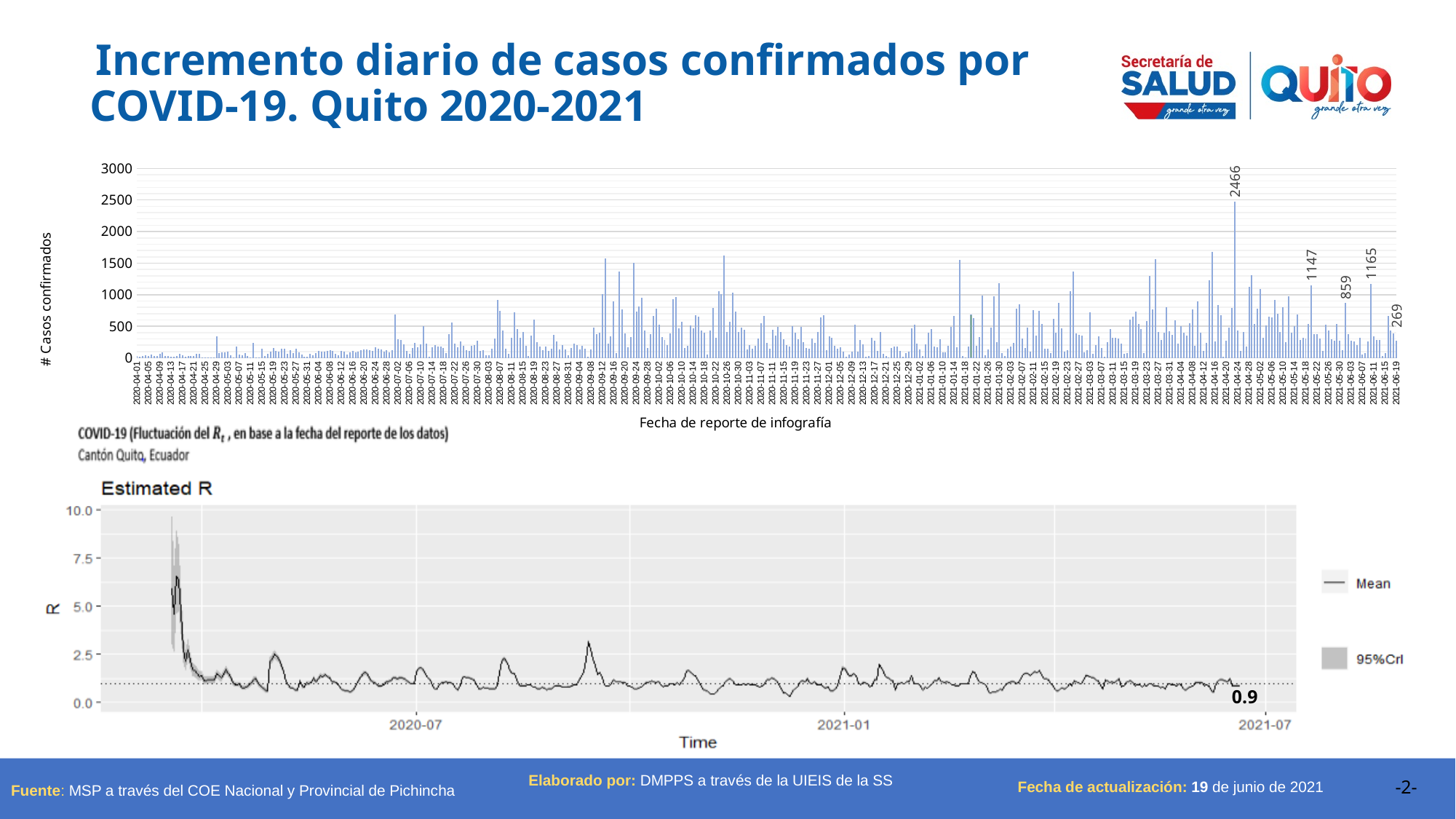
In the top chart, which labeled value is larger, 1147 or 859? 1147 What kind of chart is the bottom 'Estimated R' chart? line chart What is the label of the vertical axis of the top chart? # Casos confirmados In the top chart, what is the highest value printed as a data label? 2466 In the top chart, what value is labeled on the last bar (2021-06-19)? 269 In the bottom 'Estimated R' chart, what value is printed at the end of the line near 2021-07? 0.9 In the top chart, is the bar labeled 859 greater or less than 1000? less In the top chart, what is the difference between the labeled values 2466 and 1165? 1301 In the top chart, what is the difference between the labeled values 1165 and 1147? 18 How many series does the legend of the bottom 'Estimated R' chart list? 2 In the bottom 'Estimated R' chart, is the peak of the Mean line in early 2020 greater or less than 5.0? greater What kind of chart is the top chart showing daily confirmed cases? bar chart